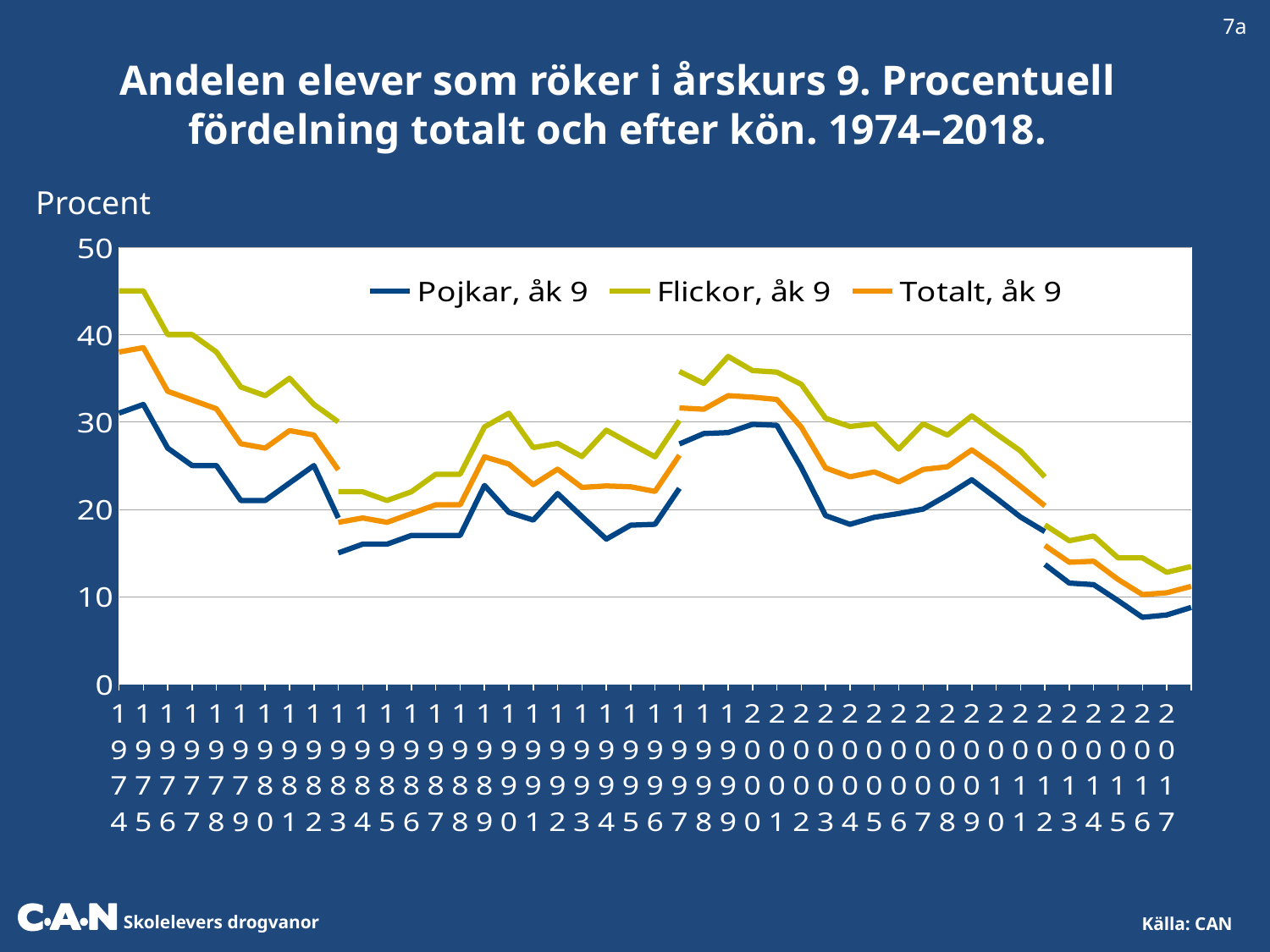
Is the value for Totalt, åk 9 in 2017 greater or less than 20? less What are the three series named in the legend? Pojkar, åk 9; Flickor, åk 9; Totalt, åk 9 What is the label shown above the vertical axis? Procent Which series has the lowest values across the whole period? Pojkar, åk 9 In 1974, which series has the higher value, Pojkar, åk 9 or Flickor, åk 9? Flickor, åk 9 Overall, do the values for Totalt, åk 9 rise or fall from 1974 to 2017? fall Is the value for Flickor, åk 9 in 2017 greater or less than 10? greater Is the value for Flickor, åk 9 in 1974 greater or less than 40? greater How many series does the legend list? 3 What kind of chart is shown on the slide? line chart